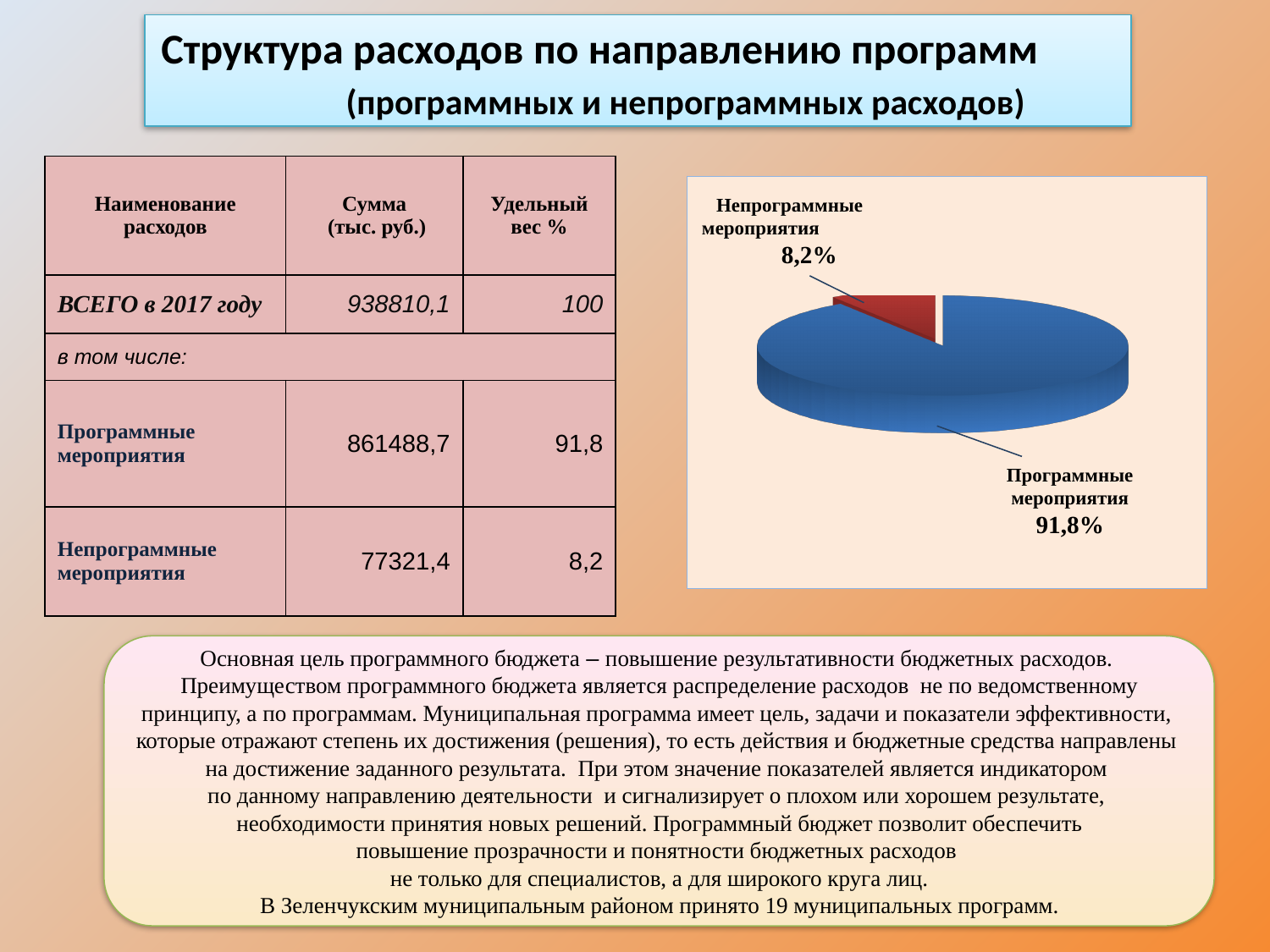
Which is larger in the pie chart: "Программные мероприятия" or "Непрограммные мероприятия"? Программные мероприятия What colour is the "Непрограммные мероприятия" slice in the pie chart? red What kind of chart is shown on the slide? pie chart What share of the pie does "Непрограммные мероприятия" have? 8,2% What is the difference in percentage points between the "Программные мероприятия" and "Непрограммные мероприятия" slices? 83,6 Which slice of the pie chart is the largest? Программные мероприятия What colour is the "Программные мероприятия" slice in the pie chart? blue Which slice of the pie chart is the smallest? Непрограммные мероприятия What is the total of the two slice percentages shown on the pie chart? 100% What share of the pie does "Программные мероприятия" have? 91,8% How many slices does the pie chart have? 2